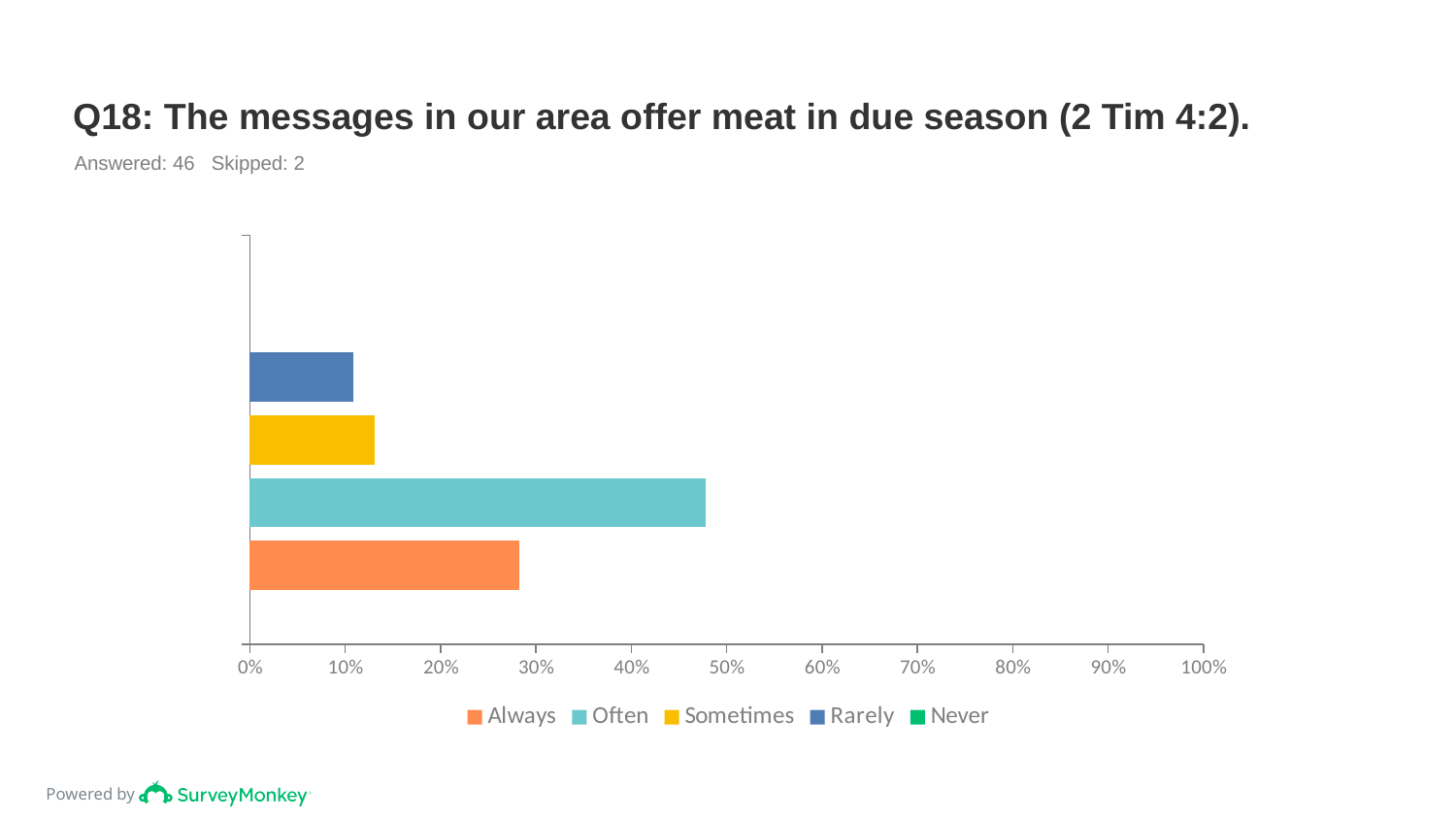
Which is larger, the value for Always or the value for Often? Often Is the value for Sometimes greater or less than 20%? less Which legend category has no visible bar on the chart? Never Is the value for Rarely greater or less than 20%? less Is the value for Always greater or less than 20%? greater Which is larger, the value for Always or the value for Sometimes? Always What kind of chart is shown on the slide? bar chart How many series does the legend list? 5 Which response category has the longest bar? Often What is the title of the chart? Q18: The messages in our area offer meat in due season (2 Tim 4:2).